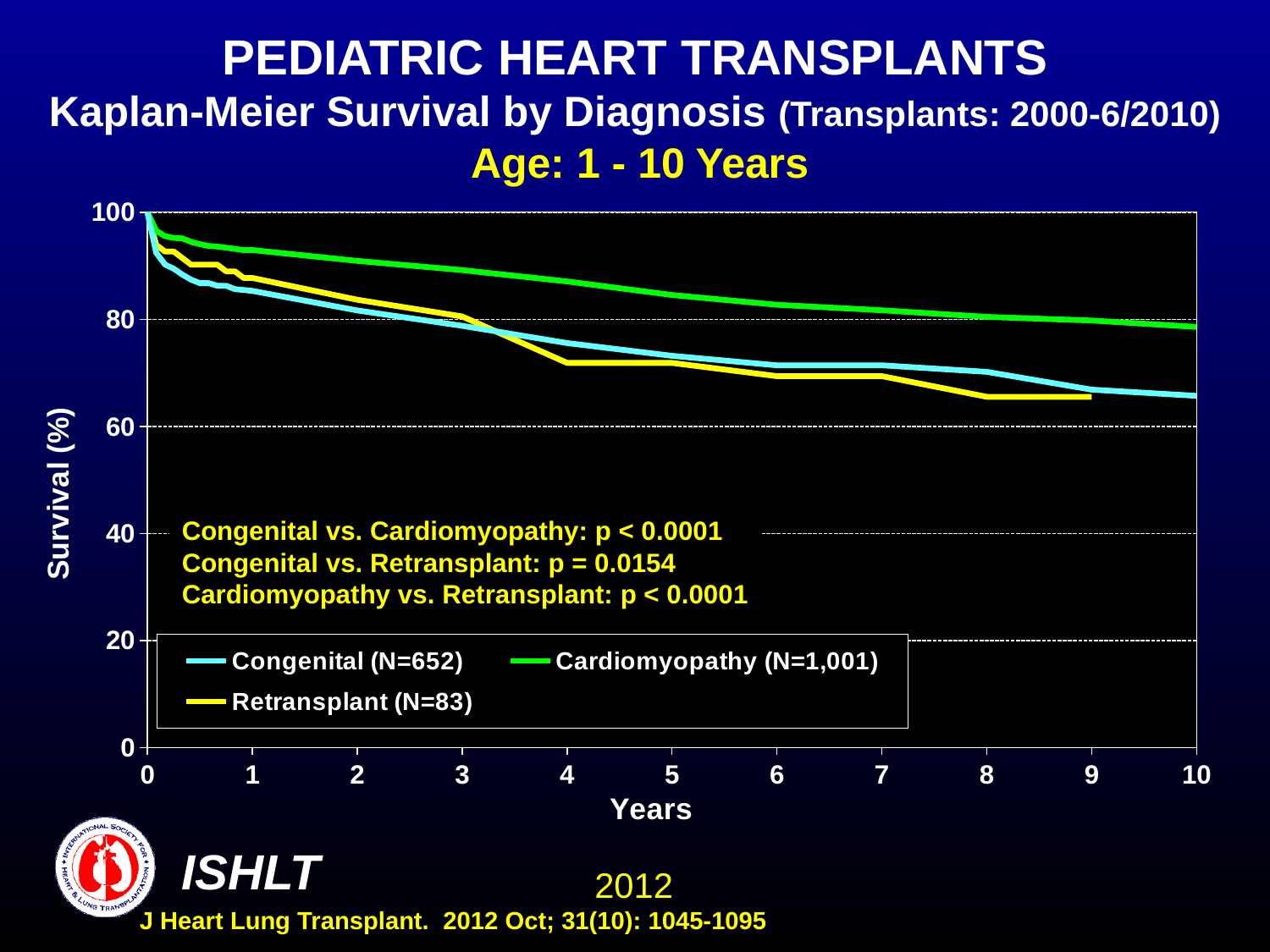
Is the survival for Cardiomyopathy at 5 years greater or less than 80? greater What p-value is given for Congenital vs. Cardiomyopathy? p < 0.0001 Do the survival curves rise or fall as years increase? fall What kind of chart is shown on the slide? line chart Is the survival for Congenital at 10 years greater or less than 60? greater What is the N for the Retransplant group shown in the legend? 83 What is the N for the Cardiomyopathy group shown in the legend? 1,001 Which diagnosis group has the highest survival at 5 years? Cardiomyopathy What are the three diagnosis groups listed in the legend? Congenital, Cardiomyopathy, Retransplant How many series does the legend list? 3 Is the survival for Retransplant at 4 years greater or less than 80? less What p-value is given for Congenital vs. Retransplant? p = 0.0154